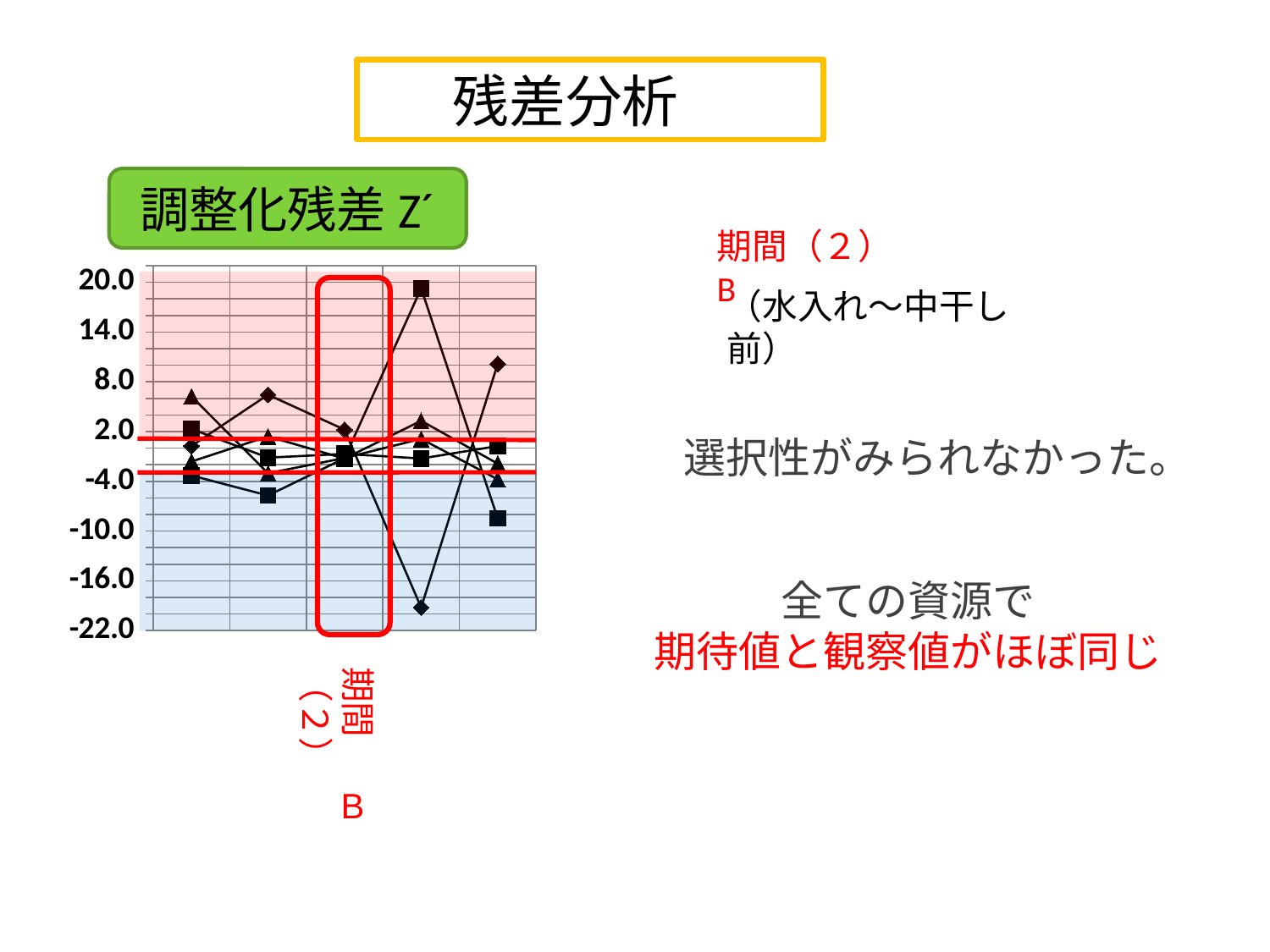
What kind of chart is shown on the slide? line chart What is the title shown in the green box above the chart? 調整化残差 Z′ What is the highest value shown on the chart's vertical axis? 20.0 Is the lowest plotted point on the chart greater or less than -16.0? less How many x-axis positions have plotted points on the chart? 5 Is the highest plotted point on the chart greater or less than 14.0? greater